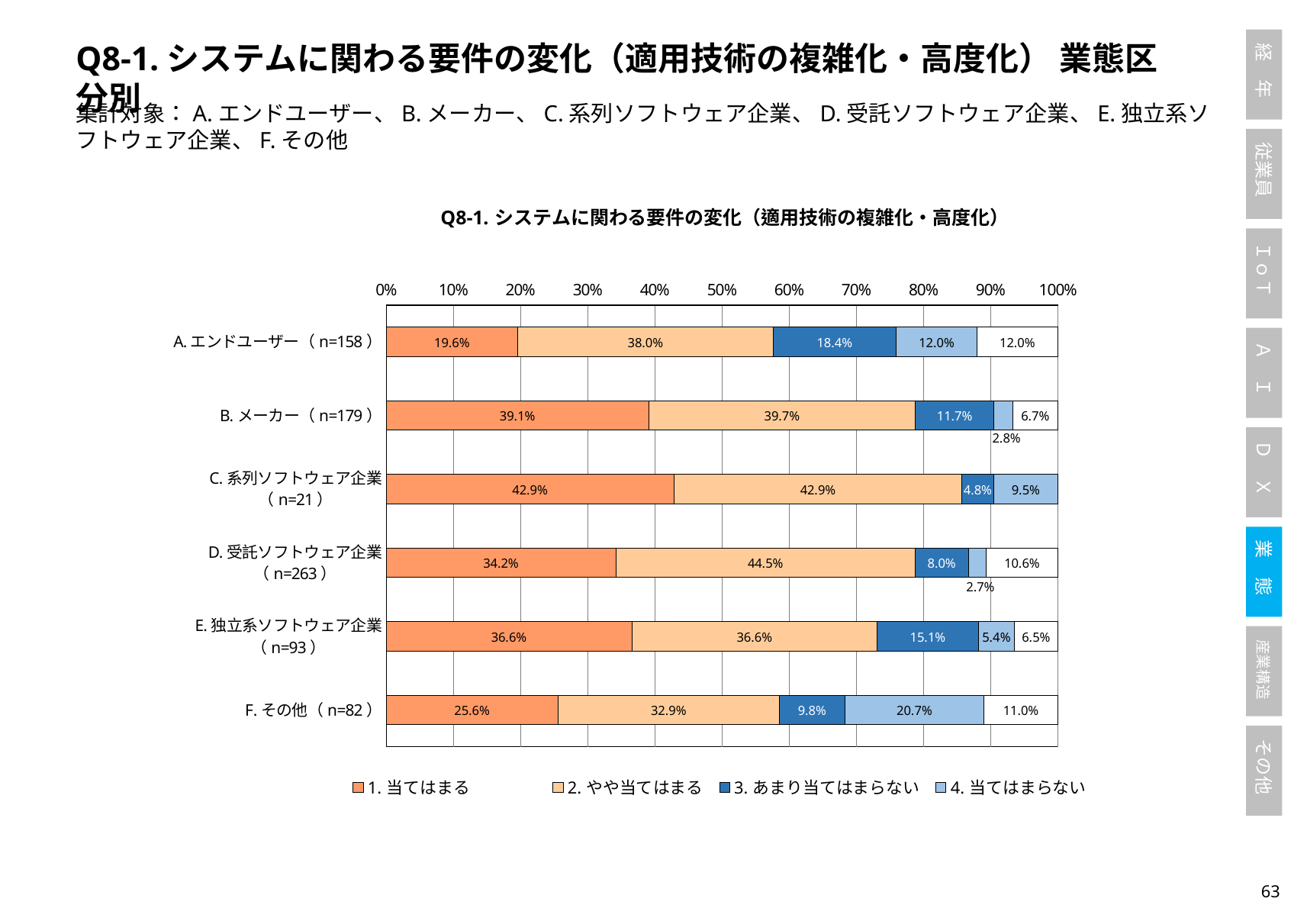
What type of chart is shown on the slide? Stacked horizontal bar chart What is the value of "3. あまり当てはまらない" for A. エンドユーザー (n=158)? 18.4% Which category has the highest value for "1. 当てはまる"? C. 系列ソフトウェア企業 (n=21) How many business-category bars are plotted in the chart? 6 What is the value of "2. やや当てはまる" for D. 受託ソフトウェア企業 (n=263)? 44.5% What is the title of the chart? Q8-1. システムに関わる要件の変化（適用技術の複雑化・高度化） How many series does the legend list? 4 What is the value of "4. 当てはまらない" for F. その他 (n=82)? 20.7% What is the value of "1. 当てはまる" for C. 系列ソフトウェア企業 (n=21)? 42.9% What is the difference between the "1. 当てはまる" values for B. メーカー and A. エンドユーザー? 19.5% Which category has the lowest value for "1. 当てはまる"? A. エンドユーザー (n=158) Which is larger: the "3. あまり当てはまらない" value for E. 独立系ソフトウェア企業 or for F. その他? E. 独立系ソフトウェア企業